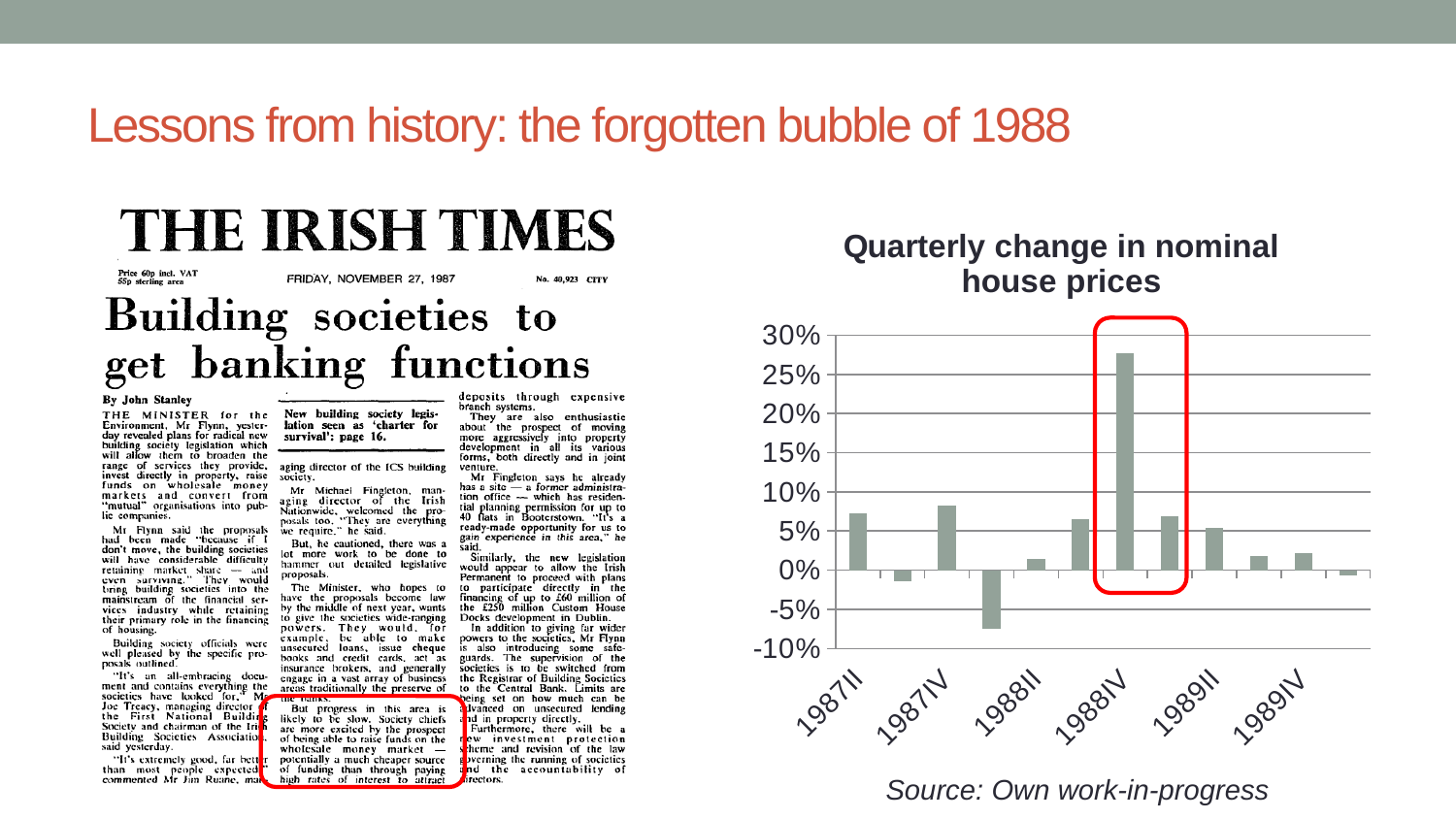
What kind of chart is shown on the right of the slide? bar chart Is the value for 1988II greater or less than 5%? less Which is larger, the value for 1987IV or the value for 1988II? 1987IV Which quarter's bar is outlined with a red box on the chart? 1988IV What is the highest value shown on the y axis of the chart? 30% Which labelled quarter has the highest quarterly change in nominal house prices? 1988IV How many quarter labels are shown on the x axis of the chart? 6 Is the value for 1989II greater or less than 10%? less Is the value for 1988IV greater or less than 25%? greater Which is larger, the value for 1988IV or the value for 1989II? 1988IV What is the title of the chart on the slide? Quarterly change in nominal house prices